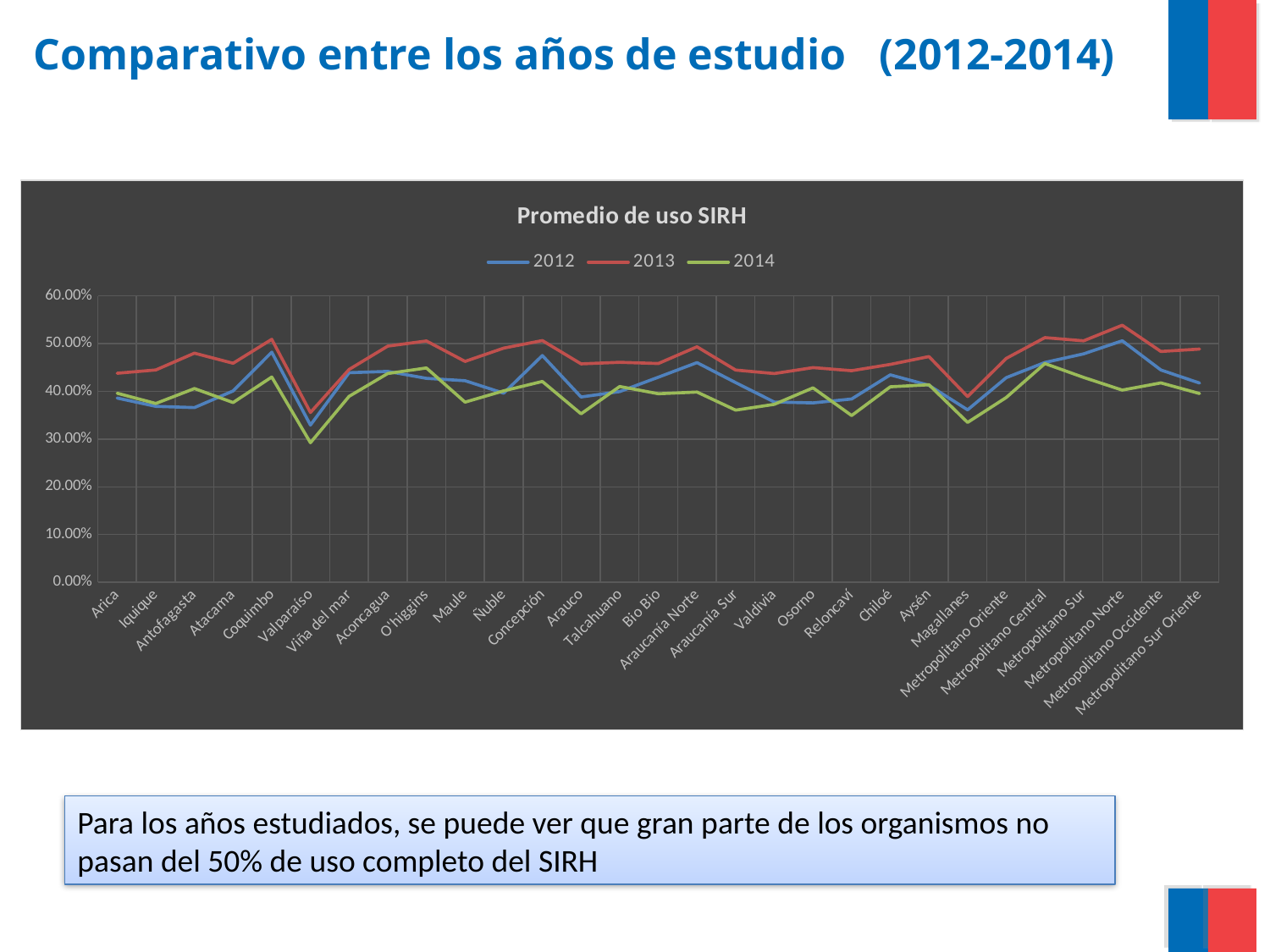
What is the title of the chart? Promedio de uso SIRH Is the 2012 value for Valparaíso greater or less than 40.00%? less How many series does the legend of the chart list? 3 Which years are listed in the chart legend? 2012, 2013, 2014 For the 2013 series, which category has the highest value? Metropolitano Norte What kind of chart is shown on the slide? Line chart At Arica, which series has the higher value, 2012 or 2013? 2013 How many categories (organisms) are plotted along the x axis? 29 Is the 2013 value for Metropolitano Norte greater or less than 50.00%? greater At Valparaíso, which series has the higher value, 2013 or 2014? 2013 Is the 2014 value for Valparaíso greater or less than 40.00%? less For the 2014 series, which category has the lowest value? Valparaíso